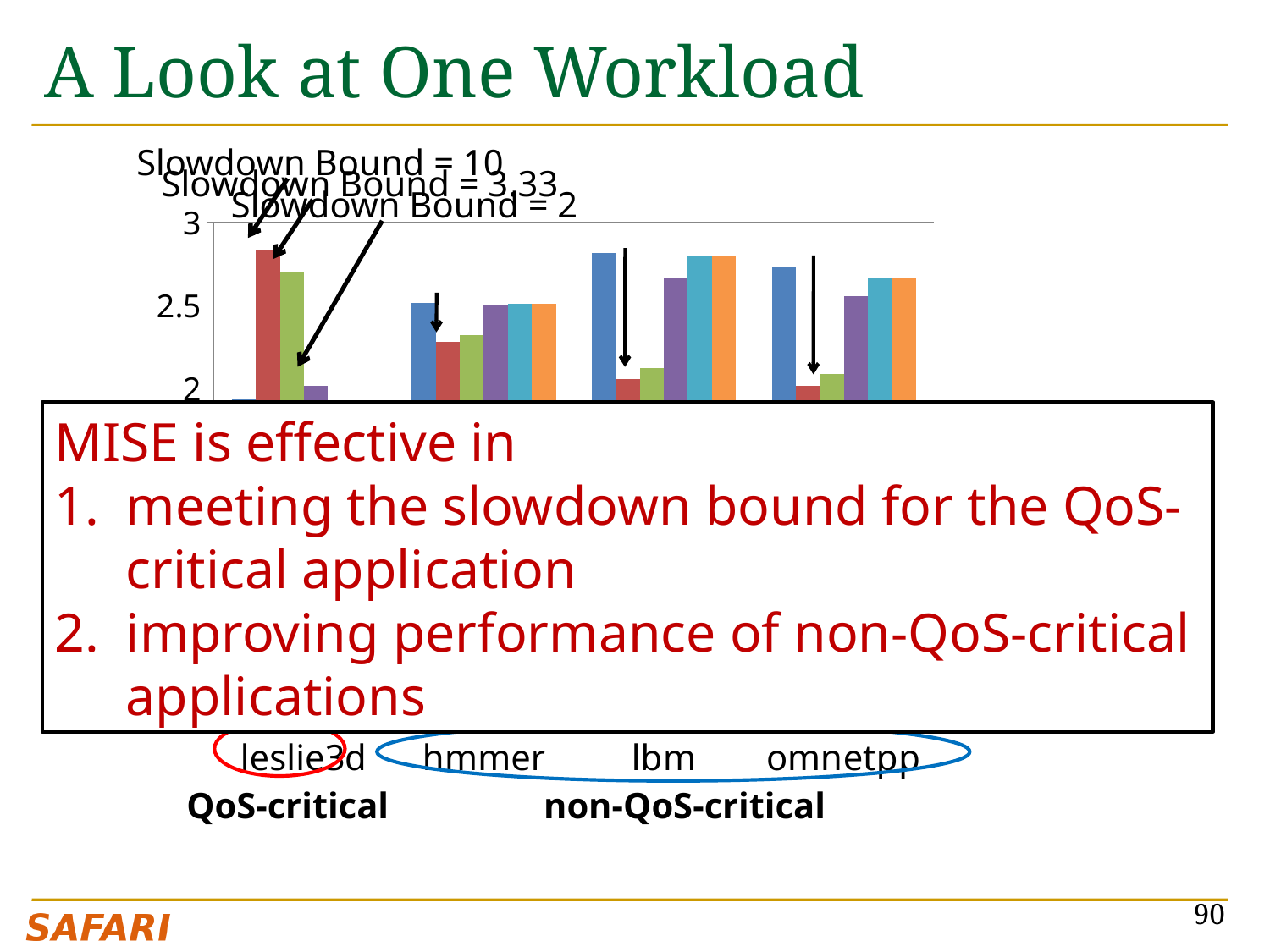
What three slowdown bound values are annotated above the chart? 10, 3.33, 2 Is the tallest bar for leslie3d greater or less than 3? less Which application on the x axis is labeled as QoS-critical? leslie3d How many application categories are shown on the x axis of the chart? 4 What kind of chart is shown on the slide? bar chart Is the tallest bar for omnetpp greater or less than 3? less Is the tallest bar for leslie3d greater or less than 2.5? greater